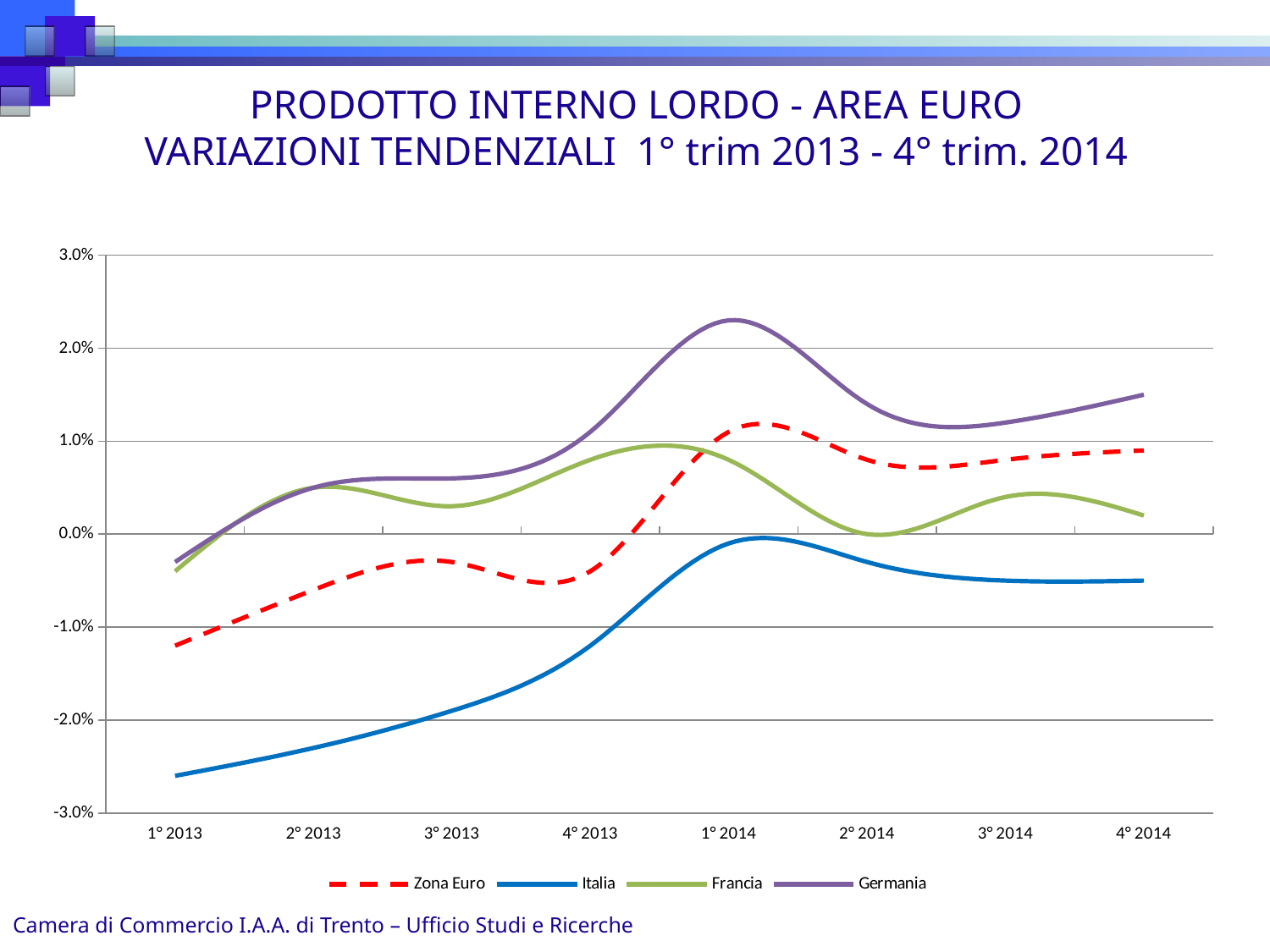
How many series does the legend list? 4 Which is larger in 1° 2014, the value for Italia or the value for Zona Euro? Zona Euro Is the value for Germania in 1° 2014 greater or less than 2.0%? greater Which series is drawn with a dashed line? Zona Euro What kind of chart is shown on the slide? Line chart Which series has the highest value in 1° 2014? Germania Which is larger in 4° 2014, the value for Germania or the value for Francia? Germania Is the value for Italia in 1° 2013 greater or less than -2.0%? less Does the Italia line rise or fall from 1° 2013 to 1° 2014? Rises Is the value for Zona Euro in 1° 2013 greater or less than -1.0%? less Which series has the lowest value in 1° 2013? Italia How many quarters are shown along the x axis? 8